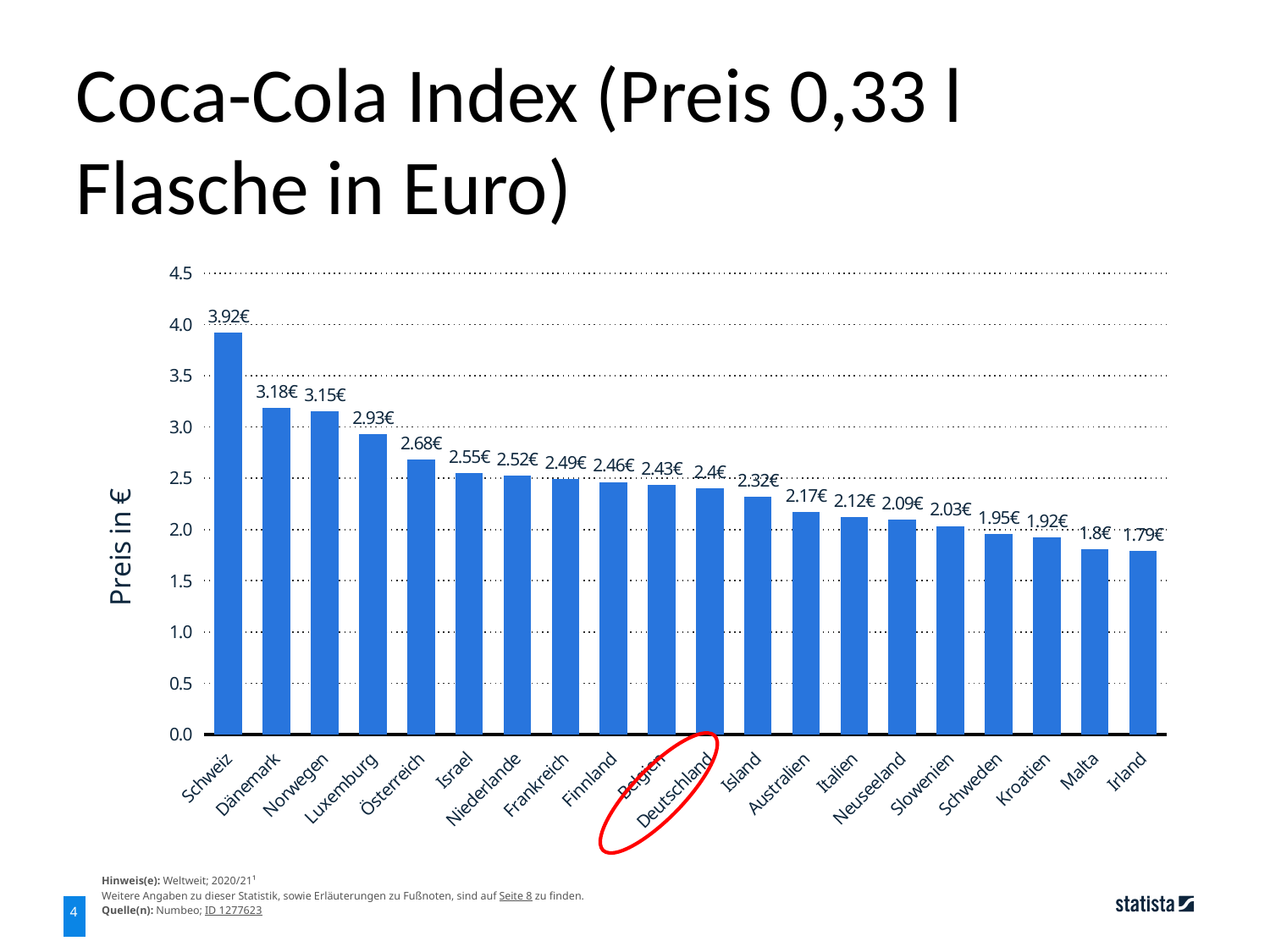
What is the price for Deutschland? 2.4€ Which country has the lowest price? Irland Which country has the highest price? Schweiz What is the price for Schweiz? 3.92€ Which has the higher price, Dänemark or Norwegen? Dänemark Do the values rise or fall from left to right along the x axis? fall What kind of chart is shown on the slide? bar chart Is the value for Luxemburg greater or less than 3.0? less What is the difference between the price for Schweiz and the price for Irland? 2.13€ Which country label is circled in red on the x axis? Deutschland How many countries are shown in the chart? 20 What is the price for Irland? 1.79€